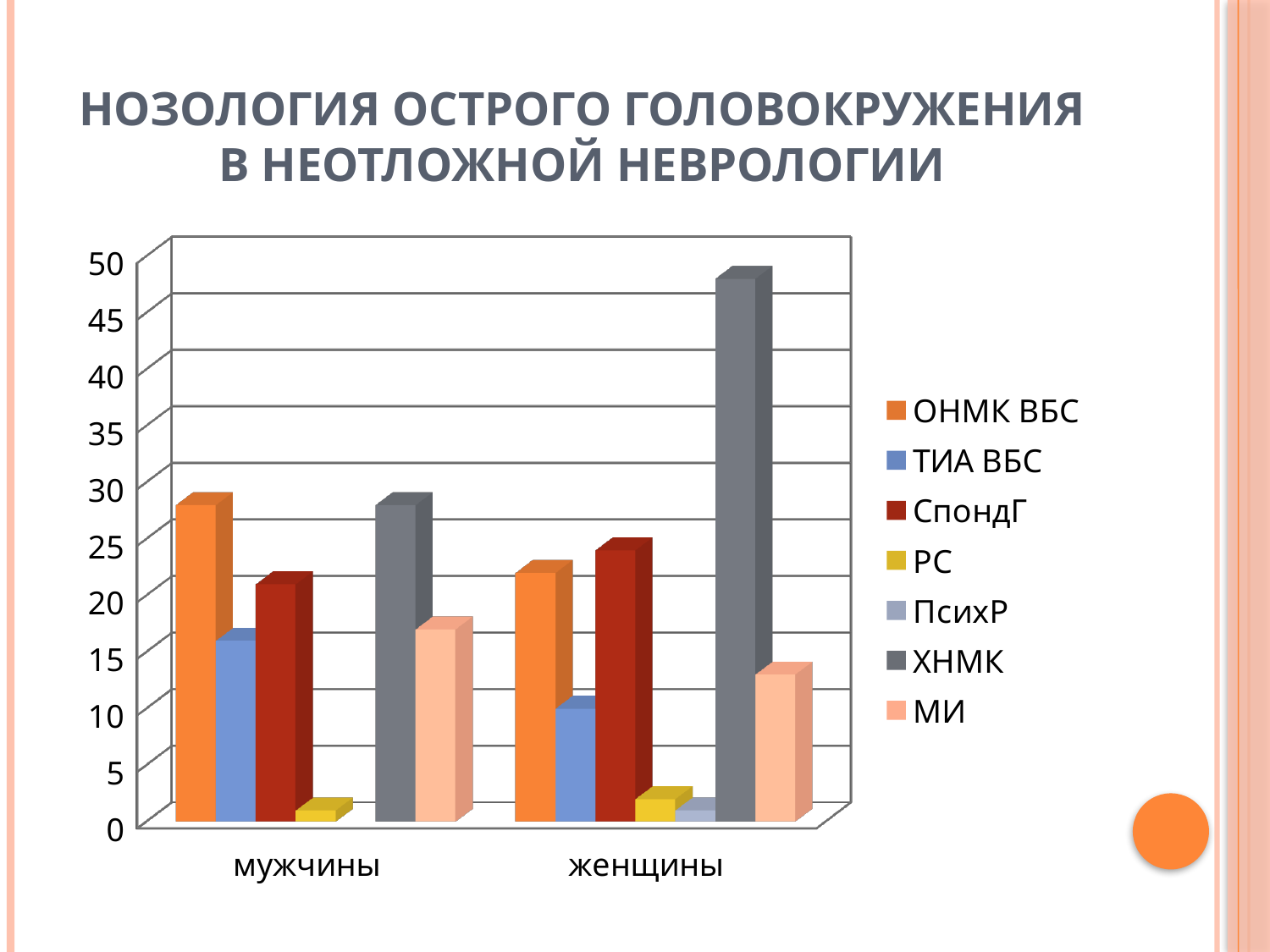
Is the value of ТИА ВБС for женщины greater or less than 15? less Is the value of ХНМК for женщины greater or less than 40? greater Which category has the larger value for ХНМК, мужчины or женщины? женщины Is the value of РС for мужчины greater or less than 5? less How many series does the legend list? 7 Which category has the larger value for ТИА ВБС, мужчины or женщины? мужчины What kind of chart is shown on the slide? bar chart How many categories are shown on the x axis? 2 What is the title of the slide? НОЗОЛОГИЯ ОСТРОГО ГОЛОВОКРУЖЕНИЯ В НЕОТЛОЖНОЙ НЕВРОЛОГИИ Which series has the lowest value for женщины? ПсихР Which series has the highest value for женщины? ХНМК